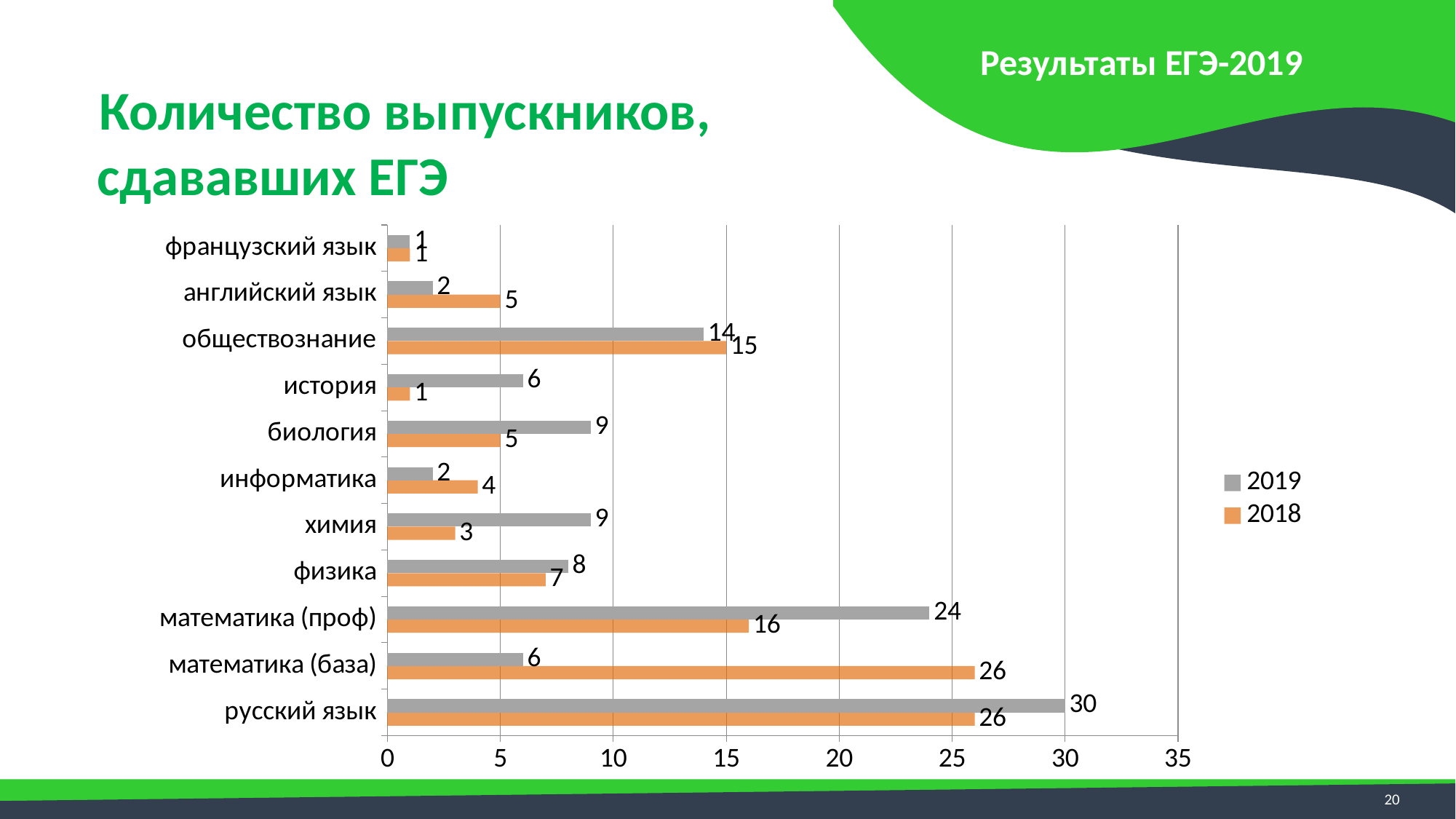
What is the 2019 value for химия? 9 Which is larger for информатика: the 2019 value or the 2018 value? 2018 How many graduates took the Russian language exam (русский язык) in 2019? 30 How many subjects (categories) are shown on the chart? 11 Which subject has the lowest 2019 value? французский язык How many series does the legend list? 2 What is the difference between the 2019 and 2018 values for математика (проф)? 8 What is the 2018 value for математика (база)? 26 What type of chart is shown on the slide? bar chart Which colour represents the 2018 series in the chart? orange Which is larger for история: the 2019 value or the 2018 value? 2019 Which subject has the highest 2019 value? русский язык